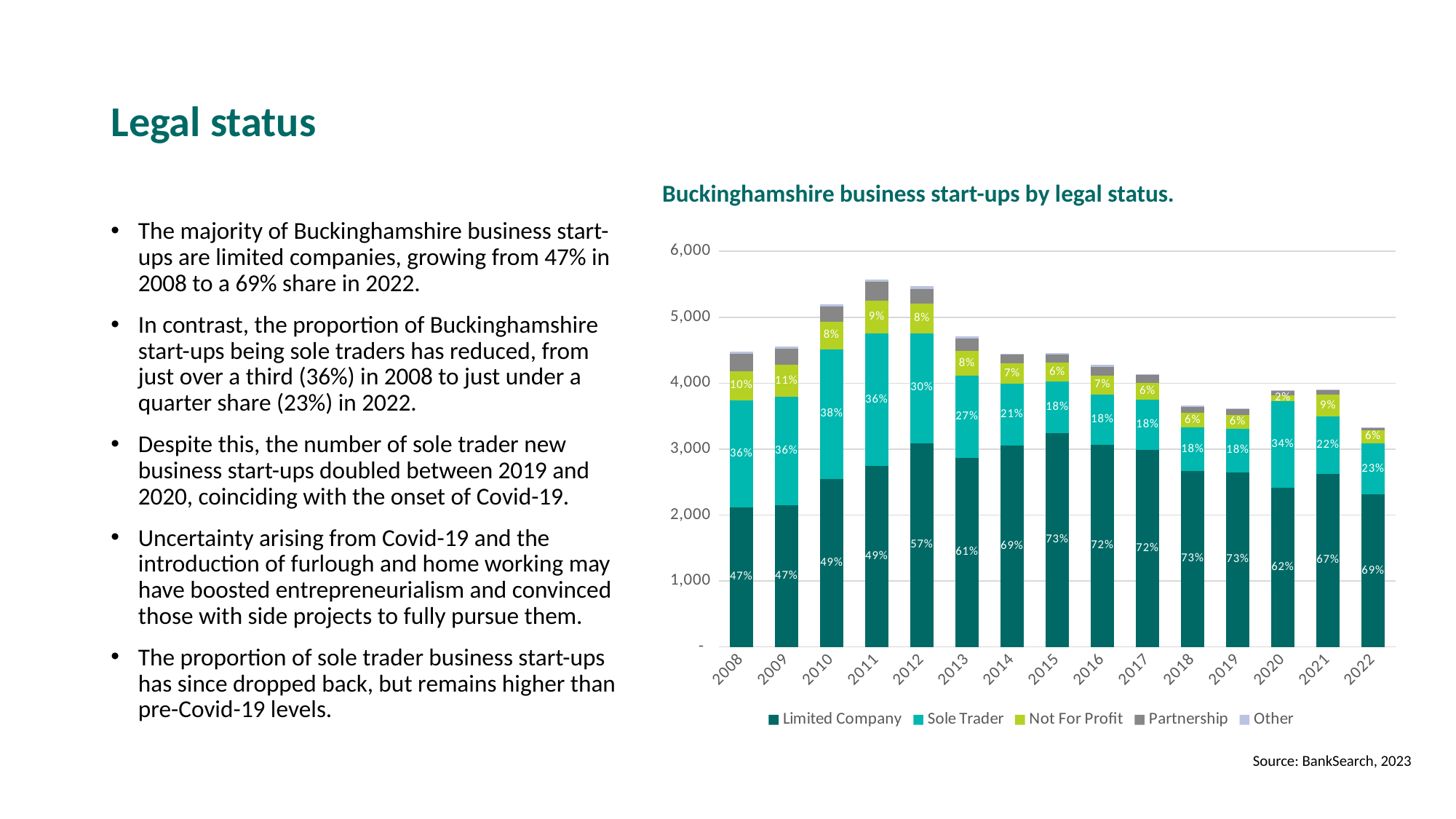
What type of chart is shown on the slide? Stacked bar chart What share of start-ups were Not For Profit in 2009? 11% In which year was the Sole Trader share of start-ups highest? 2010 How many years are shown on the x axis of the chart? 15 Which year had a larger Sole Trader share, 2020 or 2021? 2020 How many series does the chart legend list? 5 Which year has the shortest total bar in the chart? 2022 What share of Buckinghamshire business start-ups were Limited Companies in 2008? 47% What is the title of the chart? Buckinghamshire business start-ups by legal status. Which year has the tallest total bar in the chart? 2011 What share of start-ups were Sole Traders in 2022? 23% Is the total number of start-ups in 2022 greater or less than 4,000? less